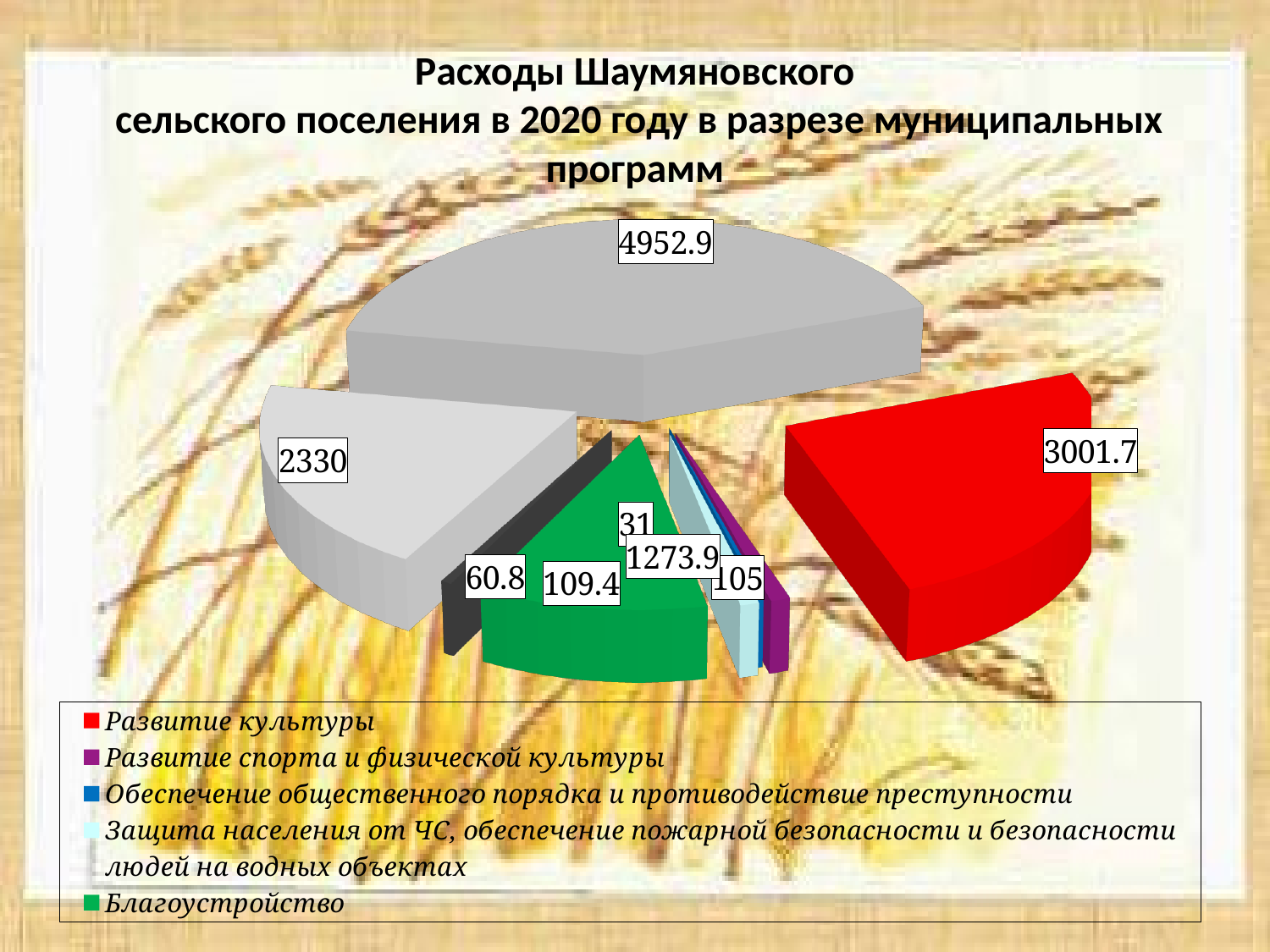
Which is larger: the value for Развитие культуры or the value for Благоустройство? Развитие культуры How many slices does the pie chart have? 8 What is the value of the green slice (Благоустройство)? 1273.9 What is the smallest value shown on the pie chart? 31 What is the largest value shown on the pie chart? 4952.9 What kind of chart is shown on the slide? Pie chart How many entries does the legend list? 5 Which year do the expenses in the chart title refer to? 2020 What colour represents Благоустройство in the legend? Green What is the difference between the largest slice (4952.9) and the red slice (3001.7)? 1951.2 What is the total of all the values labelled on the pie chart? 11864.7 What is the value of the red slice (Развитие культуры)? 3001.7